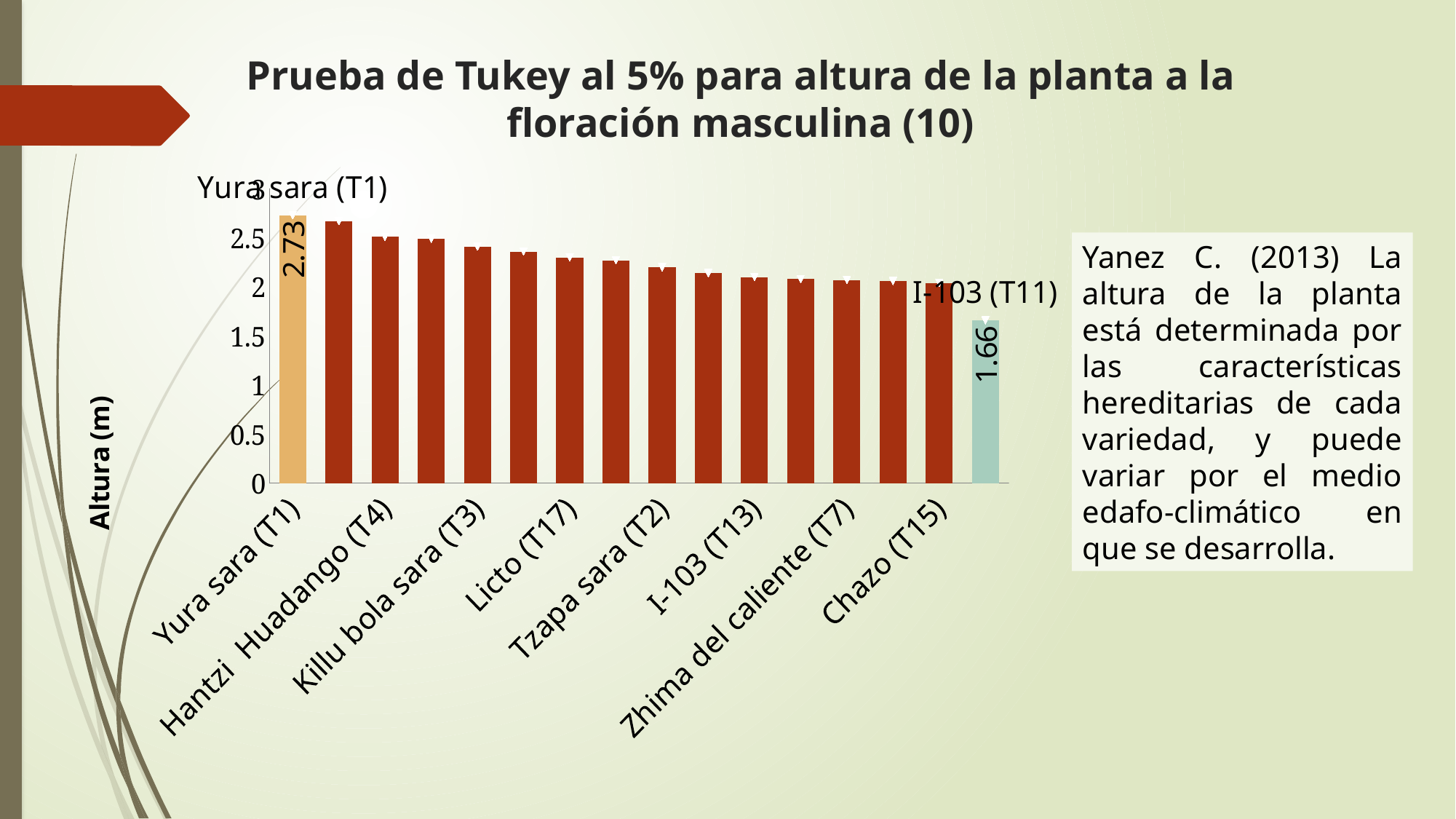
What kind of chart is shown on the slide? bar chart What is the label of the vertical axis? Altura (m) What is the value for I-103 (T11)? 1.66 What is the difference between the values for Yura sara (T1) and I-103 (T11)? 1.07 Which is larger, the value for Yura sara (T1) or the value for I-103 (T11)? Yura sara (T1) What is the value for Yura sara (T1)? 2.73 Is the value for Chazo (T15) greater or less than 2.5? less Is the value for Licto (T17) greater or less than 2? greater Which category has the lowest value? I-103 (T11) Do the values rise or fall from left to right along the x axis? fall Which category has the highest value? Yura sara (T1)